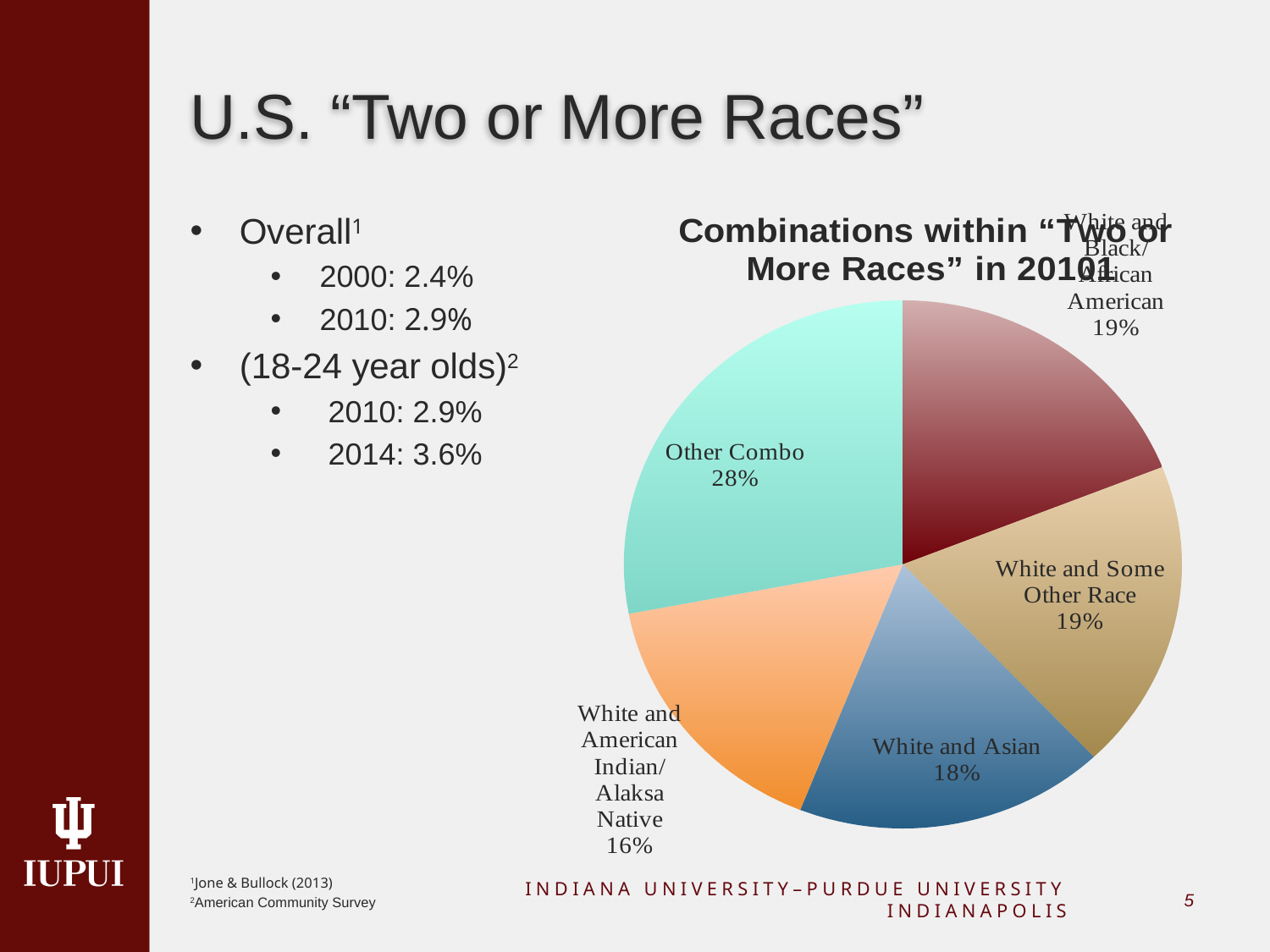
What is the difference in percentage points between Other Combo and White and Asian? 10 percentage points What is the title of the chart? Combinations within "Two or More Races" in 2010 What is the value for White and Asian? 18% What share of the pie is Other Combo? 28% How many slices does the pie chart have? 5 Which is larger, Other Combo or White and American Indian/Alaska Native? Other Combo Which category has the largest share of the pie? Other Combo What is the value for White and American Indian/Alaska Native? 16% What is the value for White and Black/African American? 19% What type of chart is shown on the slide? Pie chart What is the value for White and Some Other Race? 19% Which category has the smallest share of the pie? White and American Indian/Alaska Native